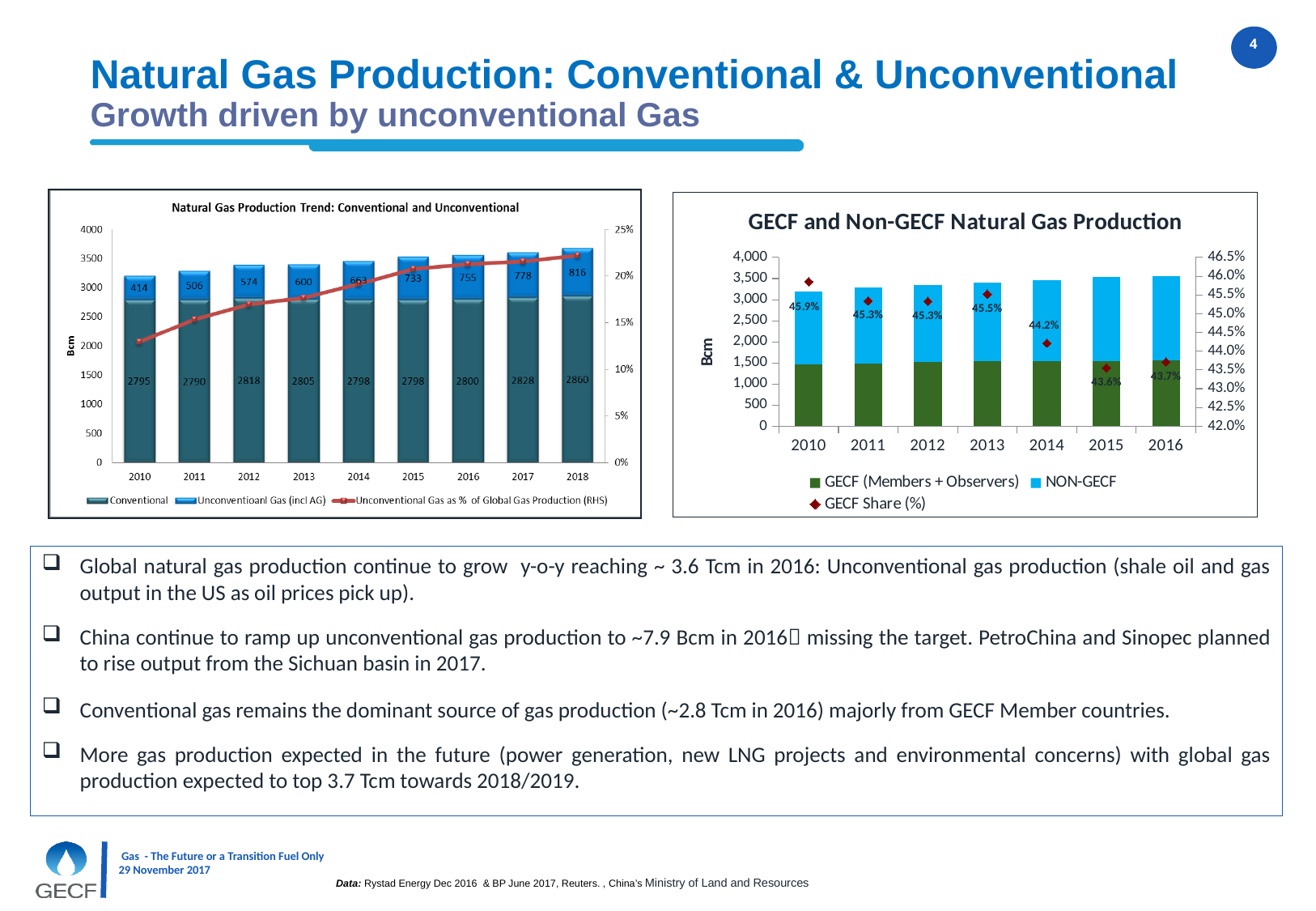
In the Natural Gas Production Trend chart, which year has the highest Unconventional Gas value? 2018 In the Natural Gas Production Trend chart, what is the Conventional value for 2018? 2860 In the GECF and Non-GECF Natural Gas Production chart, what is the GECF Share (%) for 2014? 44.2% In the Natural Gas Production Trend chart, what is the Unconventional Gas (incl AG) value for 2010? 414 In the Natural Gas Production Trend chart, what is the total of the stacked bar for 2016? 3555 In the GECF and Non-GECF Natural Gas Production chart, which year has the lowest GECF Share (%)? 2015 In the Natural Gas Production Trend chart, do the Unconventional Gas values rise or fall from 2010 to 2018? rise In the Natural Gas Production Trend chart, what is the difference between the Unconventional Gas values for 2018 and 2010? 402 In the Natural Gas Production Trend chart, which year has the lowest Conventional value? 2011 How many years are shown on the x axis of the Natural Gas Production Trend chart? 9 In the GECF and Non-GECF Natural Gas Production chart, is the GECF (Members + Observers) value for 2010 greater or less than 2,000? less How many series does the legend of the Natural Gas Production Trend chart list? 3